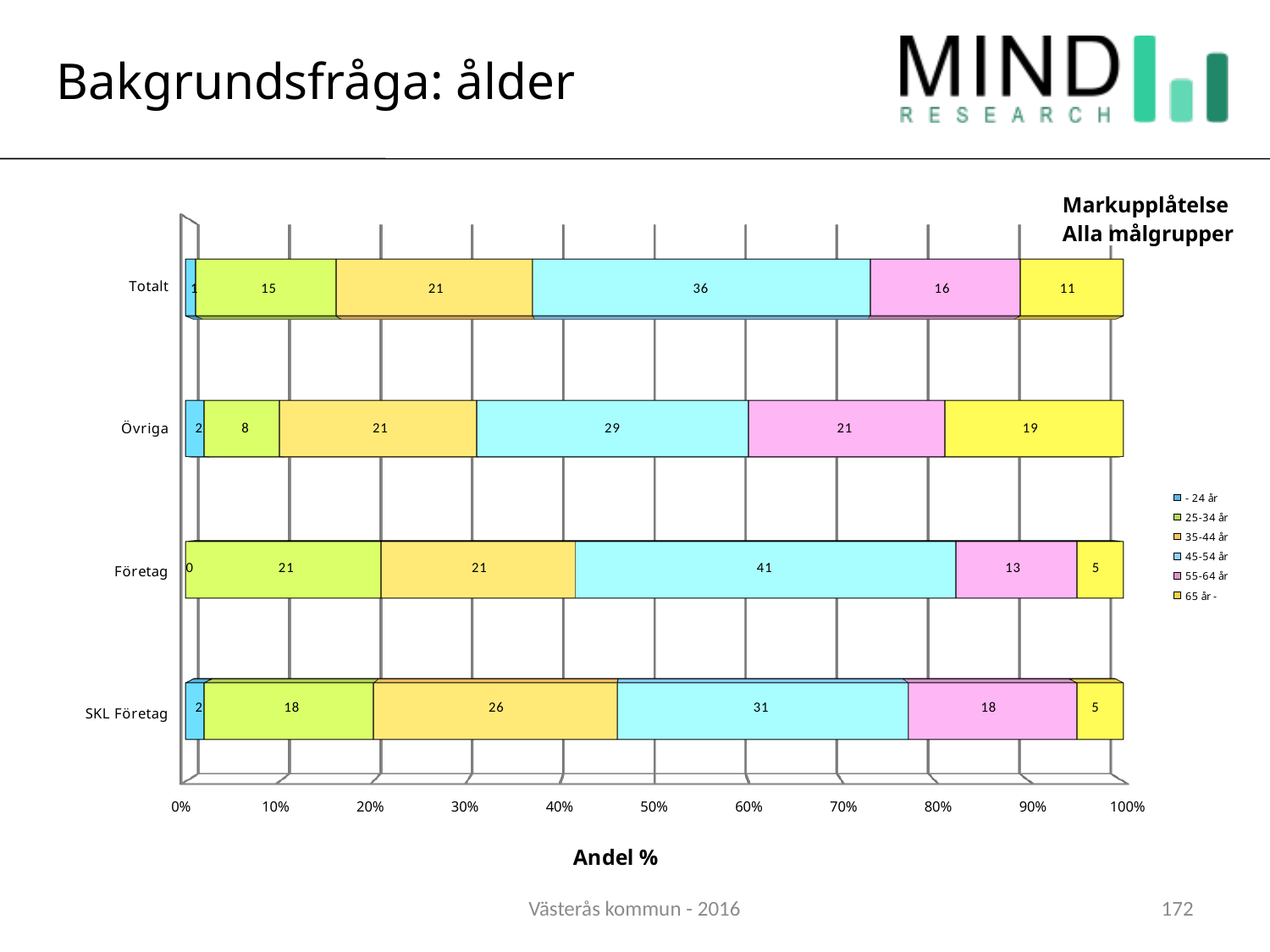
Which category has the lowest value for 25-34 år? Övriga What is the label of the horizontal axis? Andel % Which is larger: the 65 år - value for Totalt or for SKL Företag? Totalt How many series does the legend list? 6 What type of chart is shown on the slide? Stacked bar chart What is the value for 65 år - in the Övriga bar? 19 What is the difference between the 55-64 år values for Övriga and Företag? 8 Which category has the highest value for 45-54 år? Företag What is the value for 45-54 år in the Totalt bar? 36 How many categories are shown on the vertical axis? 4 What is the value for 35-44 år in the SKL Företag bar? 26 What is the value for - 24 år in the Företag bar? 0